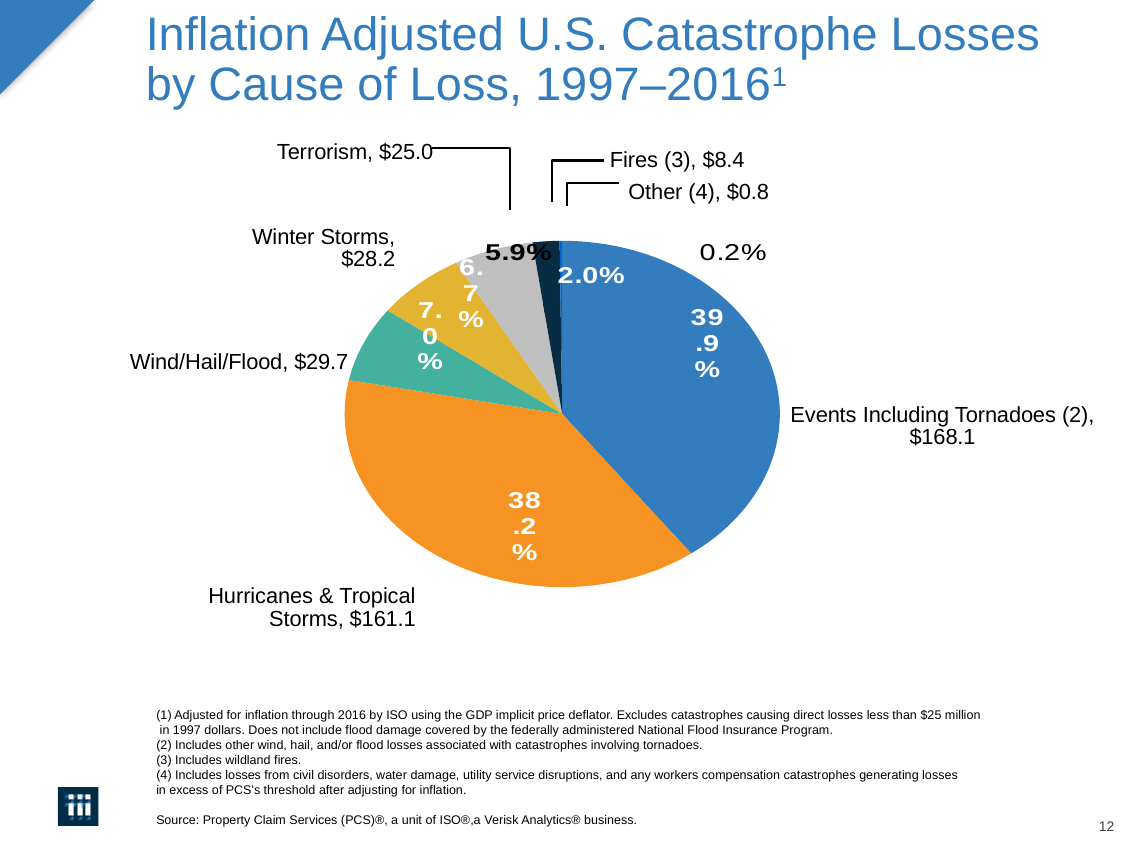
What is the value shown for Hurricanes & Tropical Storms? $161.1 Which category has the smallest share of the pie? Other (4) What is the value shown for Events Including Tornadoes (2)? $168.1 What is the value shown for Fires (3)? $8.4 What kind of chart is shown on the slide? Pie chart What is the value shown for Terrorism? $25.0 Which is larger, the value for Winter Storms or the value for Terrorism? Winter Storms How many categories (slices) does the pie chart show? 7 What percentage share of the pie does Winter Storms represent? 6.7% What is the difference between the values for Events Including Tornadoes (2) and Hurricanes & Tropical Storms? $7.0 Which category has the largest share of the pie? Events Including Tornadoes (2) What percentage share of the pie does Wind/Hail/Flood represent? 7.0%